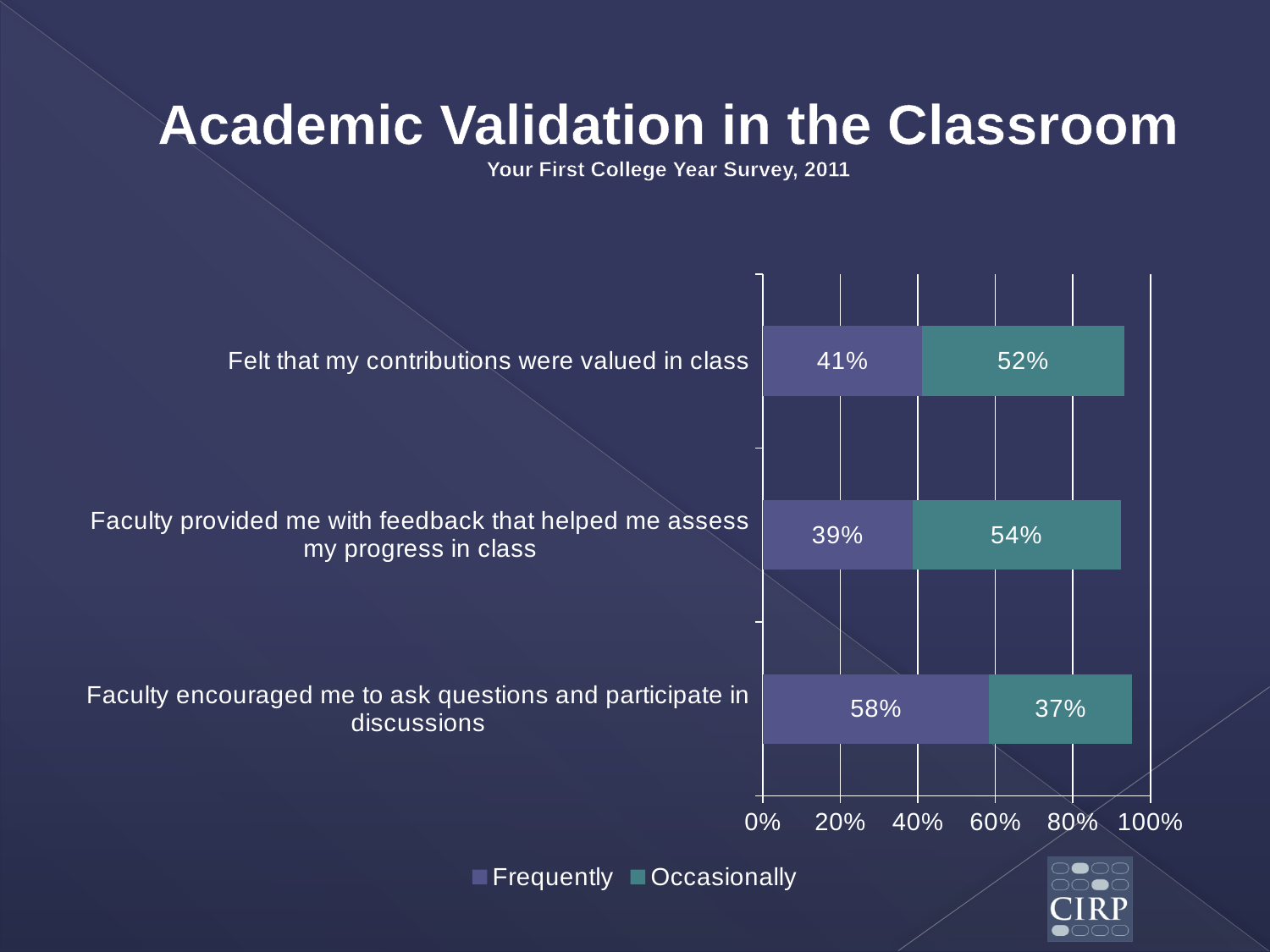
What is the "Frequently" value for "Felt that my contributions were valued in class"? 41% Which is larger for "Felt that my contributions were valued in class": the "Frequently" value or the "Occasionally" value? Occasionally What is the "Occasionally" value for "Faculty provided me with feedback that helped me assess my progress in class"? 54% Which category has the highest "Frequently" value? Faculty encouraged me to ask questions and participate in discussions What is the difference between the "Frequently" and "Occasionally" values for "Faculty encouraged me to ask questions and participate in discussions"? 21% What kind of chart is shown on the slide? Stacked bar chart Which category has the lowest "Occasionally" value? Faculty encouraged me to ask questions and participate in discussions What is the combined total of "Frequently" and "Occasionally" for "Faculty provided me with feedback that helped me assess my progress in class"? 93% How many series does the legend list? 2 What is the title of the chart on the slide? Academic Validation in the Classroom What is the "Frequently" value for "Faculty encouraged me to ask questions and participate in discussions"? 58% How many categories are shown on the chart? 3